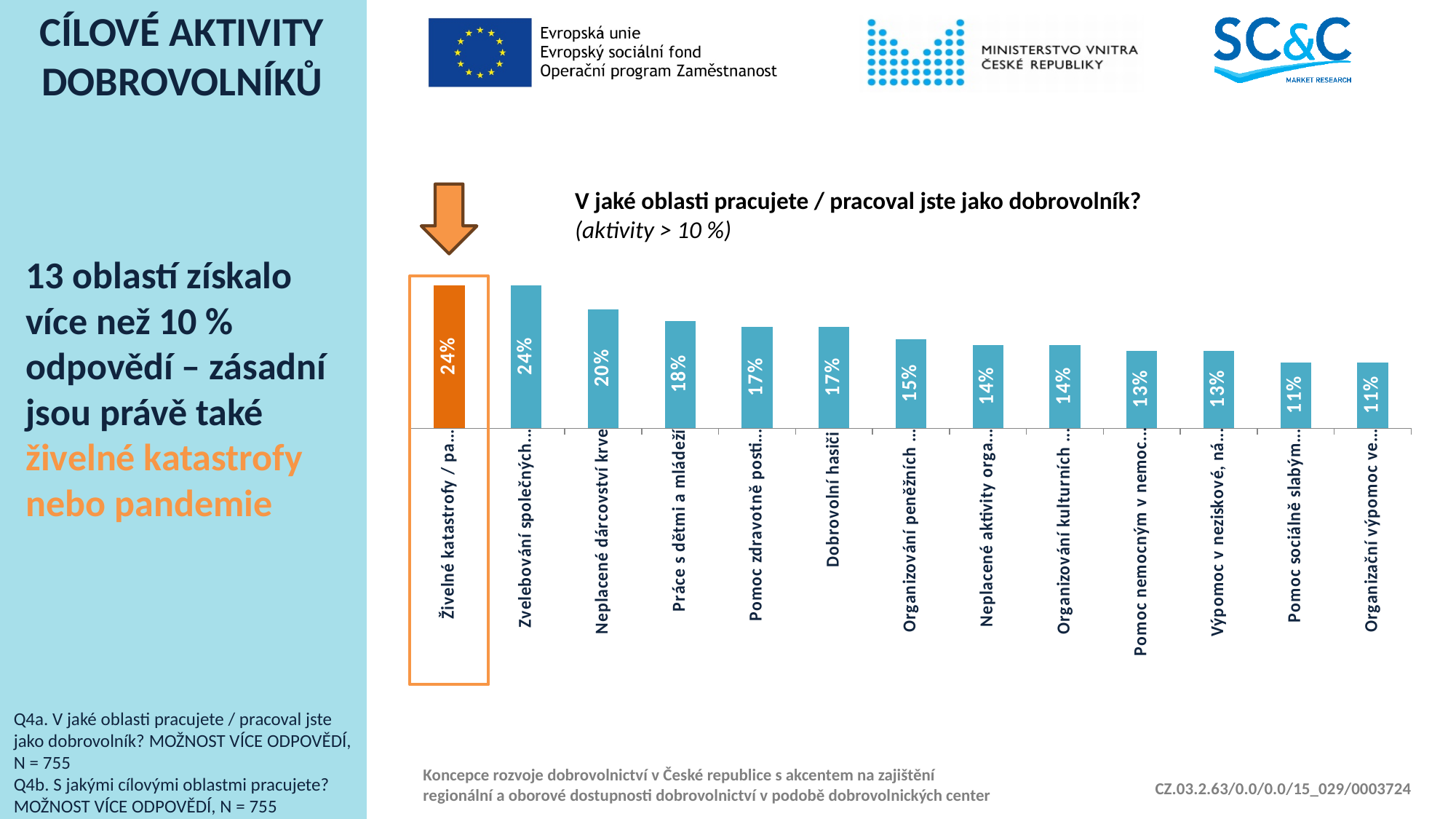
Which has a larger value, Práce s dětmi a mládeží or Dobrovolní hasiči? Práce s dětmi a mládeží Do the values rise or fall from left to right along the x axis? Fall What kind of chart is shown on the slide? Bar chart What is the value for Práce s dětmi a mládeží? 18% What is the highest value shown in the chart? 24% How many bars (categories) are shown in the chart? 13 What is the difference between the values for Neplacené dárcovství krve and Dobrovolní hasiči? 3 percentage points What is the value for Neplacené dárcovství krve? 20% What is the lowest value shown in the chart? 11% What is the value of the orange bar (Živelné katastrofy / pandemie)? 24% Which bar is highlighted in orange? Živelné katastrofy / pandemie What is the value for Dobrovolní hasiči? 17%